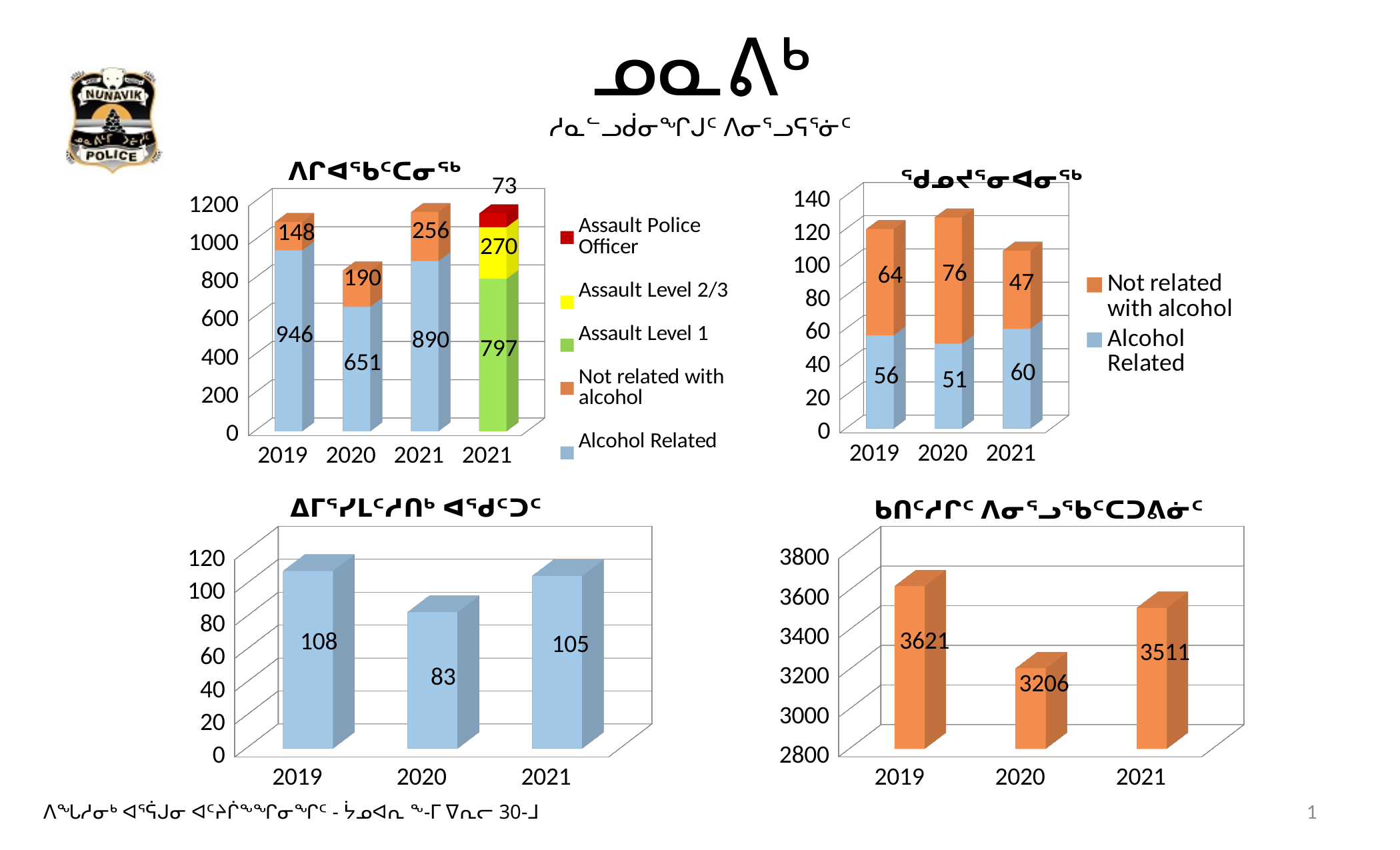
What kind of chart is the bottom-right chart? bar chart In the top-right chart, what is the Not related with alcohol value for 2020? 76 How many series does the legend of the top-left chart list? 5 In the bottom-right chart, what is the difference between the values for 2019 and 2021? 110 In the top-left chart, what is the Alcohol Related value for 2019? 946 In the top-right chart, which year has the highest Alcohol Related value? 2021 In the top-left chart, what is the Assault Level 2/3 value for the second 2021 bar? 270 In the top-left chart, what is the total of the stacked bar for 2020? 841 In the bottom-left chart, what is the value for 2020? 83 In the top-right chart, what is the difference between the Not related with alcohol values for 2020 and 2021? 29 In the bottom-left chart, which year has the lowest value? 2020 In the bottom-right chart, what is the value for 2019? 3621